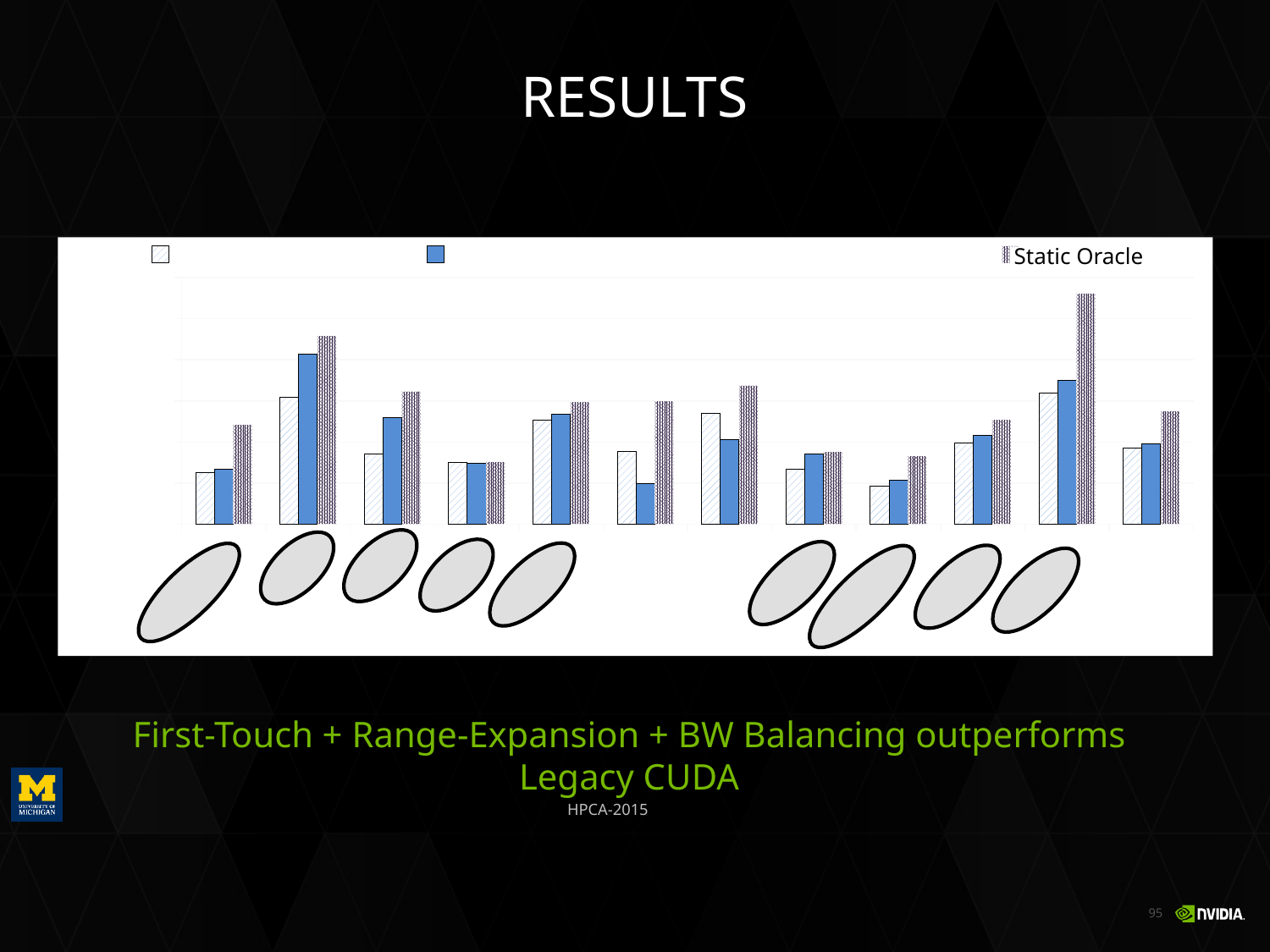
How many groups of bars (categories) are plotted on the chart? 12 Which legend entry on the chart has a readable label? Static Oracle What fill pattern is used for the Static Oracle series? purple hatched pattern How many series does the chart's legend list? 3 What kind of chart is shown on the slide? bar chart Which series has the tallest bar anywhere on the chart? Static Oracle